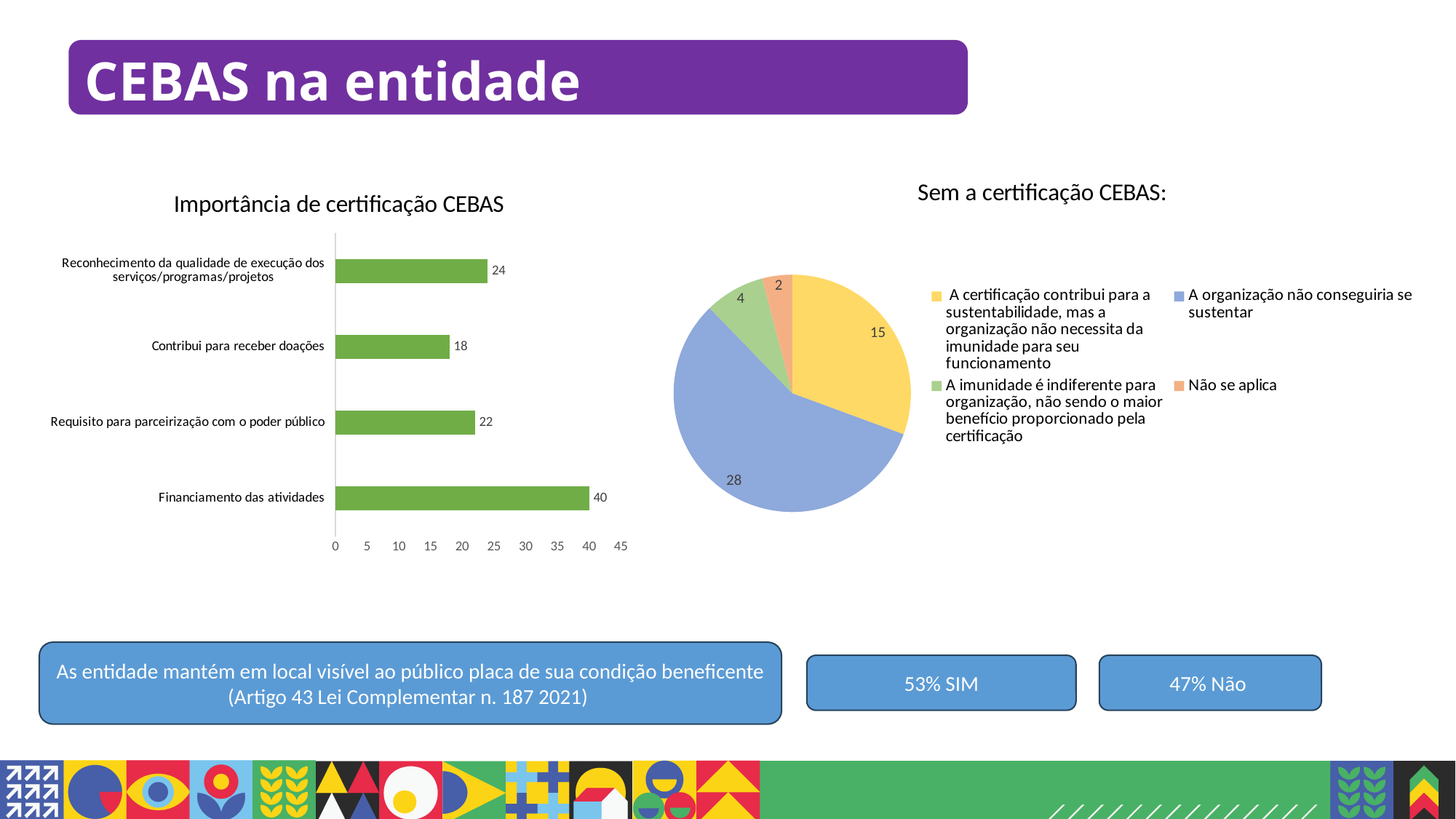
In the chart 'Importância de certificação CEBAS', what is the value for 'Contribui para receber doações'? 18 In the chart 'Importância de certificação CEBAS', what is the value for 'Financiamento das atividades'? 40 In the pie chart 'Sem a certificação CEBAS:', which is larger: the slice for 'A imunidade é indiferente para organização...' or the slice for 'Não se aplica'? A imunidade é indiferente para organização, não sendo o maior benefício proporcionado pela certificação In the pie chart 'Sem a certificação CEBAS:', what is the value for 'A organização não conseguiria se sustentar'? 28 In the chart 'Importância de certificação CEBAS', which category has the highest value? Financiamento das atividades In the chart 'Importância de certificação CEBAS', how many categories are shown? 4 In the chart 'Importância de certificação CEBAS', what is the difference between 'Financiamento das atividades' and 'Requisito para parceirização com o poder público'? 18 In the chart 'Importância de certificação CEBAS', which category has the lowest value? Contribui para receber doações In the pie chart 'Sem a certificação CEBAS:', which slice is the largest? A organização não conseguiria se sustentar What kind of chart is 'Importância de certificação CEBAS'? Bar chart In the pie chart 'Sem a certificação CEBAS:', how many entries does the legend list? 4 In the pie chart 'Sem a certificação CEBAS:', what is the value for 'Não se aplica'? 2